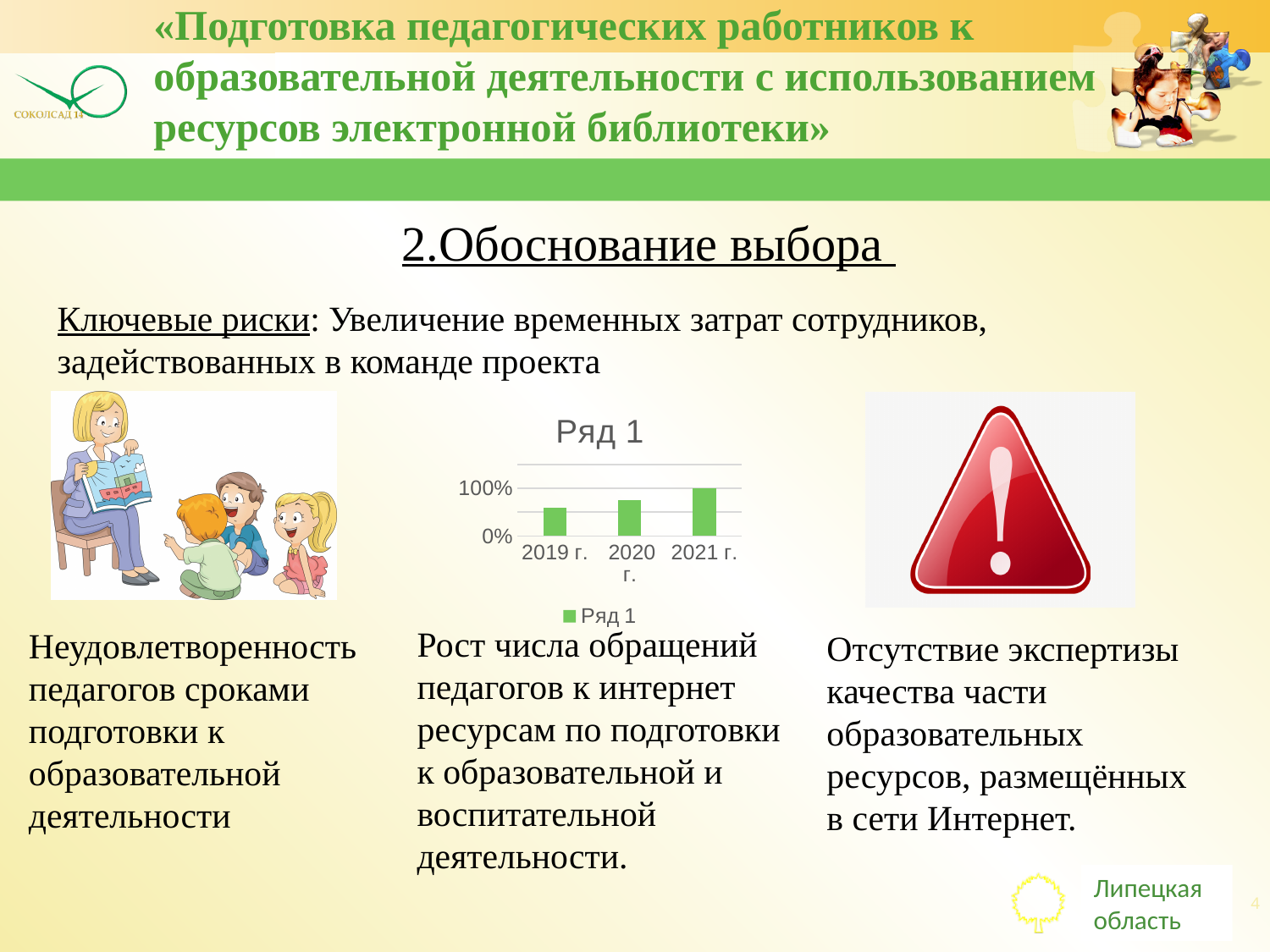
Which category has the highest bar in the chart? 2021 г. Do the values in the chart rise or fall from 2019 г. to 2021 г.? rise Which category has the lowest bar in the chart? 2019 г. Which is larger in the chart, the value for 2020 г. or the value for 2021 г.? 2021 г. What is the name of the series listed in the chart legend? Ряд 1 Which is larger in the chart, the value for 2019 г. or the value for 2020 г.? 2020 г. Is the value for 2020 г. greater or less than 100%? less What is the title of the chart on the slide? Ряд 1 How many series does the chart legend list? 1 What kind of chart is shown on the slide? bar chart How many categories are shown on the x axis of the chart? 3 Is the value for 2019 г. greater or less than 100%? less